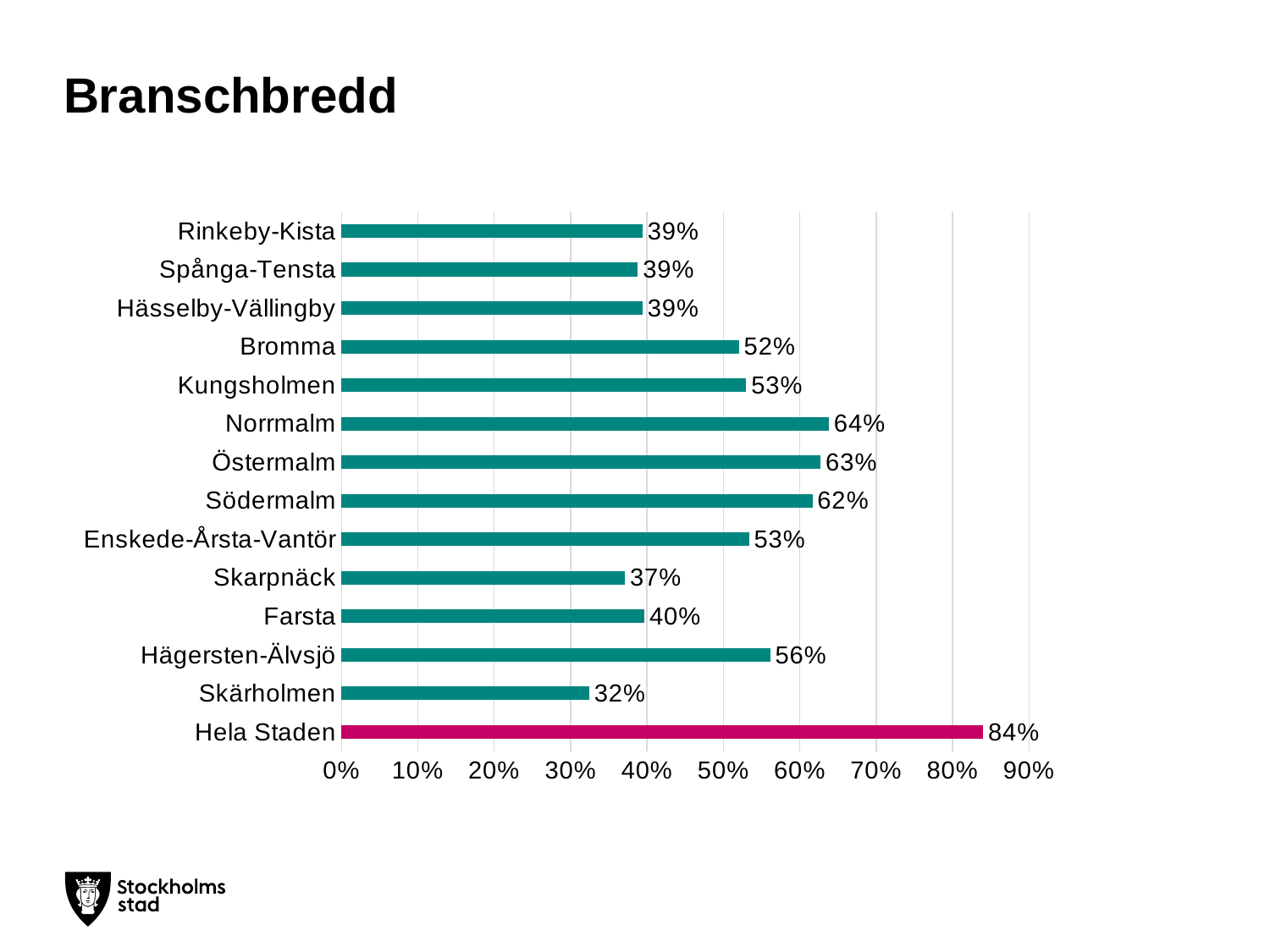
Which category has the highest value? Hela Staden What is the value for Skärholmen? 32% What is the difference between the values for Hägersten-Älvsjö and Farsta? 16% What is the value for Hela Staden? 84% How many categories are shown on the chart? 14 What is the title of the slide? Branschbredd What is the value for Hägersten-Älvsjö? 56% What is the value for Norrmalm? 64% Which category has the lowest value? Skärholmen Which is larger, the value for Bromma or the value for Skarpnäck? Bromma What is the difference between the values for Hela Staden and Norrmalm? 20% What kind of chart is shown on the slide? Bar chart